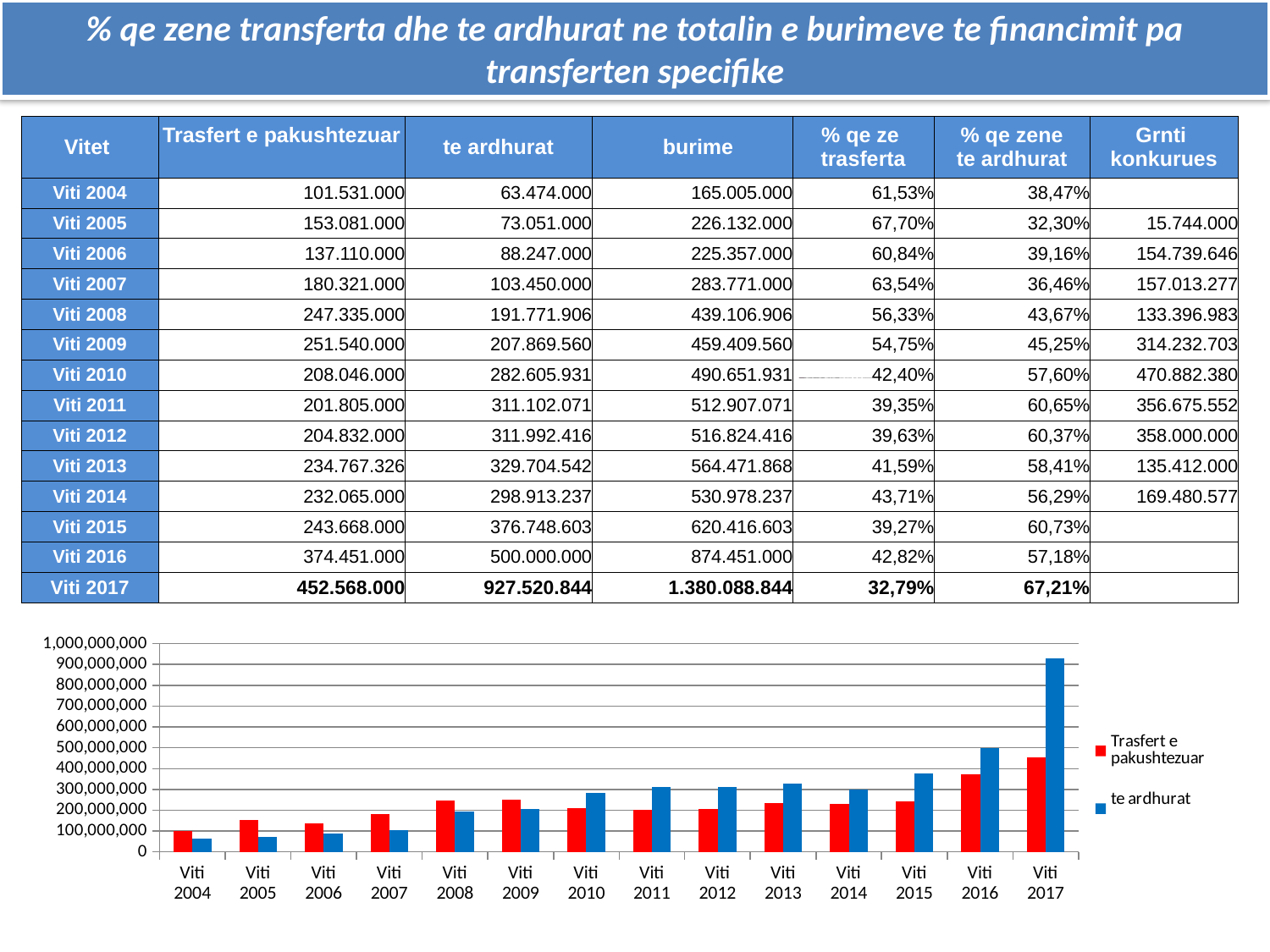
In the chart, what colour are the bars for te ardhurat? blue In the chart, which is larger in Viti 2007: Trasfert e pakushtezuar or te ardhurat? Trasfert e pakushtezuar In the chart, which year has the highest value for Trasfert e pakushtezuar? Viti 2017 How many series does the chart legend list? 2 In the chart, is the value for te ardhurat in Viti 2004 greater or less than 100,000,000? less In the chart, which year has the lowest value for te ardhurat? Viti 2004 In the chart, which year has the highest value for te ardhurat? Viti 2017 How many years are shown on the x axis of the chart? 14 In the chart, is the value for te ardhurat in Viti 2017 greater or less than 800,000,000? greater In the chart, is the value for Trasfert e pakushtezuar in Viti 2017 greater or less than 400,000,000? greater What kind of chart is shown at the bottom of the slide? bar chart In the chart, which is larger in Viti 2010: Trasfert e pakushtezuar or te ardhurat? te ardhurat